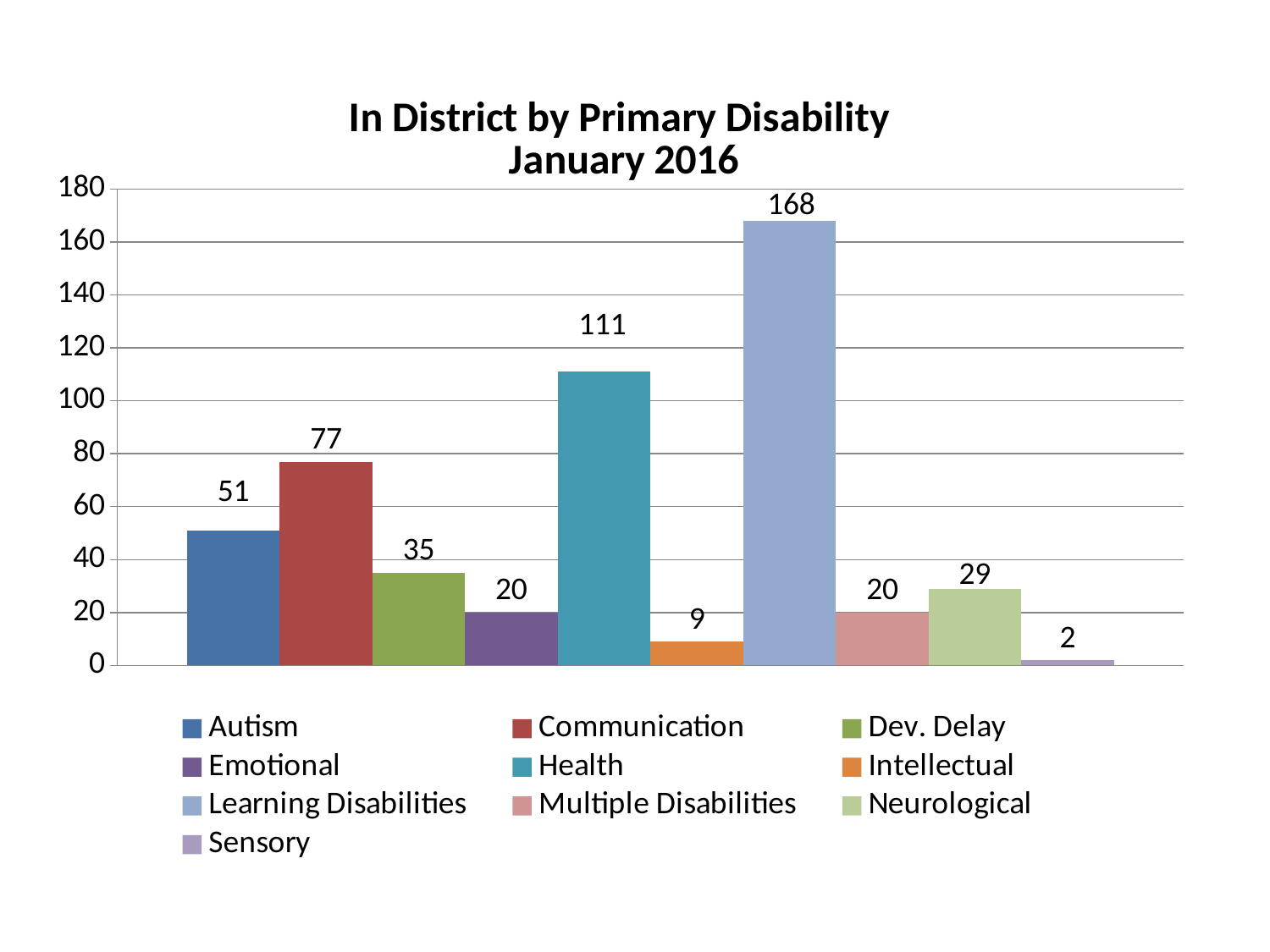
How many categories are shown in the chart? 10 Which category has the highest value? Learning Disabilities Is the value for Neurological greater or less than 40? less What is the value for Communication? 77 What is the title of the chart? In District by Primary Disability January 2016 Which category has the lowest value? Sensory Which is larger, the value for Communication or the value for Autism? Communication What kind of chart is shown on the slide? bar chart What is the difference between the values for Autism and Dev. Delay? 16 What is the value for Health? 111 What is the difference between the values for Learning Disabilities and Health? 57 What is the value for Learning Disabilities? 168